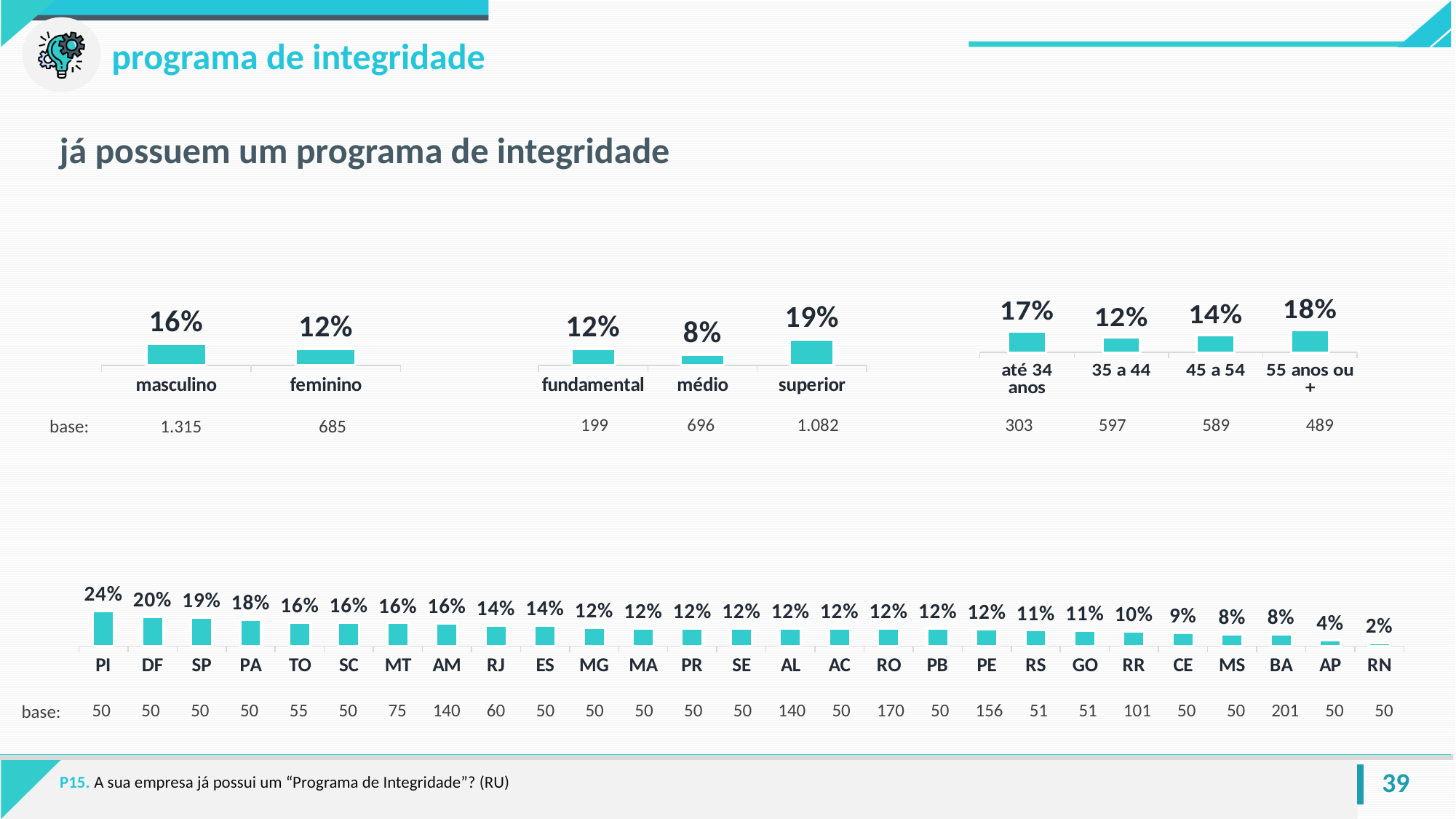
In the education chart (top middle), which category has the lowest value? médio In the gender chart (top left), what is the value for masculino? 16% In the state chart at the bottom, what is the value for AM? 16% In the state chart at the bottom, which state has the lowest value? RN In the state chart at the bottom, which state has the highest value? PI In the gender chart (top left), what is the value for feminino? 12% In the age chart (top right), what is the value for 35 a 44? 12% In the age chart (top right), how many age groups are shown? 4 What type of chart is the state chart at the bottom of the slide? bar chart In the state chart at the bottom, how many states are shown? 27 In the education chart (top middle), what is the difference between superior and fundamental? 7% In the age chart (top right), which age group has the highest value? 55 anos ou +